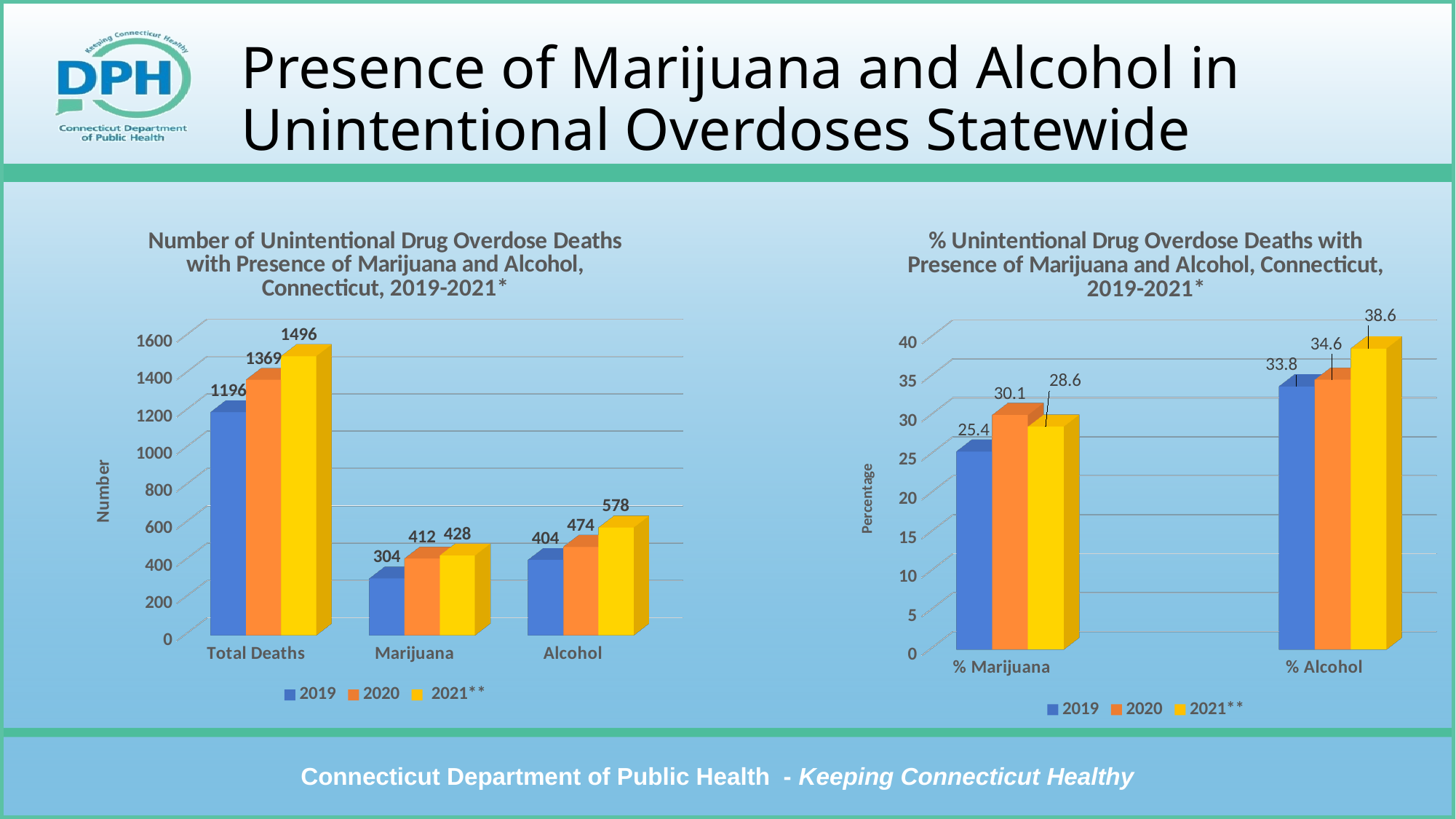
In the left chart (Number of Unintentional Drug Overdose Deaths), what is the value for Total Deaths in 2021? 1496 In the right chart (% Unintentional Drug Overdose Deaths), what is the value for % Marijuana in 2020? 30.1 In the right chart (% Unintentional Drug Overdose Deaths), what is the difference between % Alcohol in 2021 and % Alcohol in 2019? 4.8 In the right chart (% Unintentional Drug Overdose Deaths), which is larger: % Marijuana in 2020 or % Marijuana in 2021? % Marijuana in 2020 In the right chart (% Unintentional Drug Overdose Deaths), what is the value for % Alcohol in 2021? 38.6 In the left chart (Number of Unintentional Drug Overdose Deaths), what is the difference between Alcohol in 2021 and Alcohol in 2019? 174 In the left chart (Number of Unintentional Drug Overdose Deaths), what is the value for Alcohol in 2020? 474 In the left chart (Number of Unintentional Drug Overdose Deaths), which year has the highest value for Total Deaths? 2021 In the right chart (% Unintentional Drug Overdose Deaths), how many series does the legend list? 3 What kind of chart is the left chart (Number of Unintentional Drug Overdose Deaths)? Bar chart In the left chart (Number of Unintentional Drug Overdose Deaths), how many categories are shown on the x axis? 3 In the left chart (Number of Unintentional Drug Overdose Deaths), what is the value for Marijuana in 2019? 304